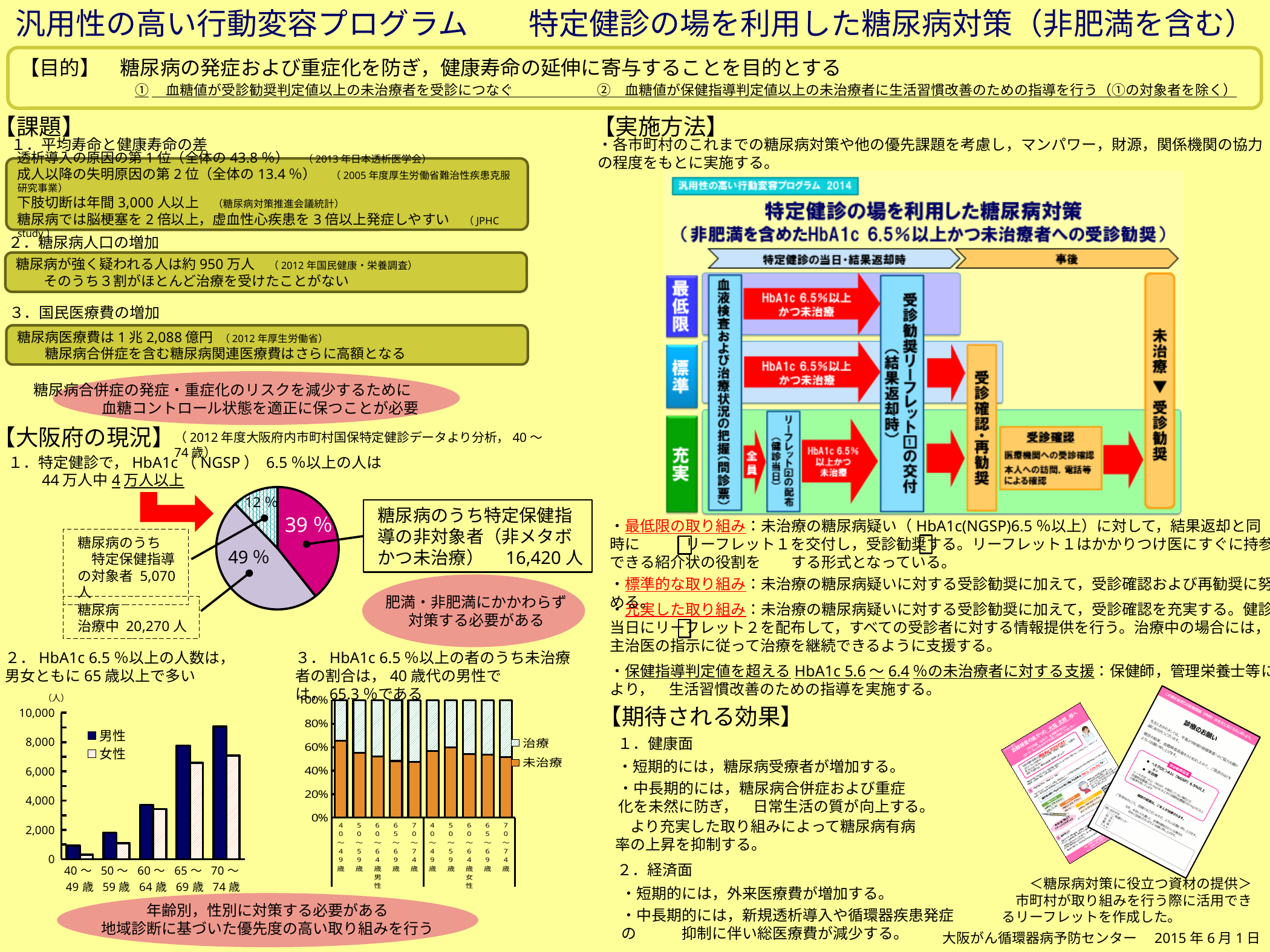
In the stacked bar chart of 治療/未治療 (bottom middle), is the 未治療 share for 男性 40～49歳 greater or less than 60%? greater In the pie chart, what percentage is shown for the largest slice? 49 % How many slices does the pie chart have? 3 In the bar chart of HbA1c 6.5% or higher by age and sex (bottom left), is the 女性 value for 40～49歳 greater or less than 2,000? less In the bar chart of HbA1c 6.5% or higher by age and sex (bottom left), is the 男性 value for 70～74歳 greater or less than 8,000? greater In the bar chart of HbA1c 6.5% or higher by age and sex (bottom left), which age group has the tallest 男性 bar? 70～74歳 In the pie chart, what percentage is shown for the magenta slice (糖尿病のうち特定保健指導の非対象者)? 39 % In the bar chart of HbA1c 6.5% or higher by age and sex (bottom left), how many series does the legend list? 2 What type of chart is the 治療/未治療 chart in the bottom middle of the slide? stacked bar chart In the bar chart of HbA1c 6.5% or higher by age and sex (bottom left), do the 男性 values rise or fall as age increases from 40～49歳 to 70～74歳? rise In the bar chart of HbA1c 6.5% or higher by age and sex (bottom left), which is larger for 65～69歳, 男性 or 女性? 男性 In the pie chart, what percentage is shown for the smallest slice? 12 %